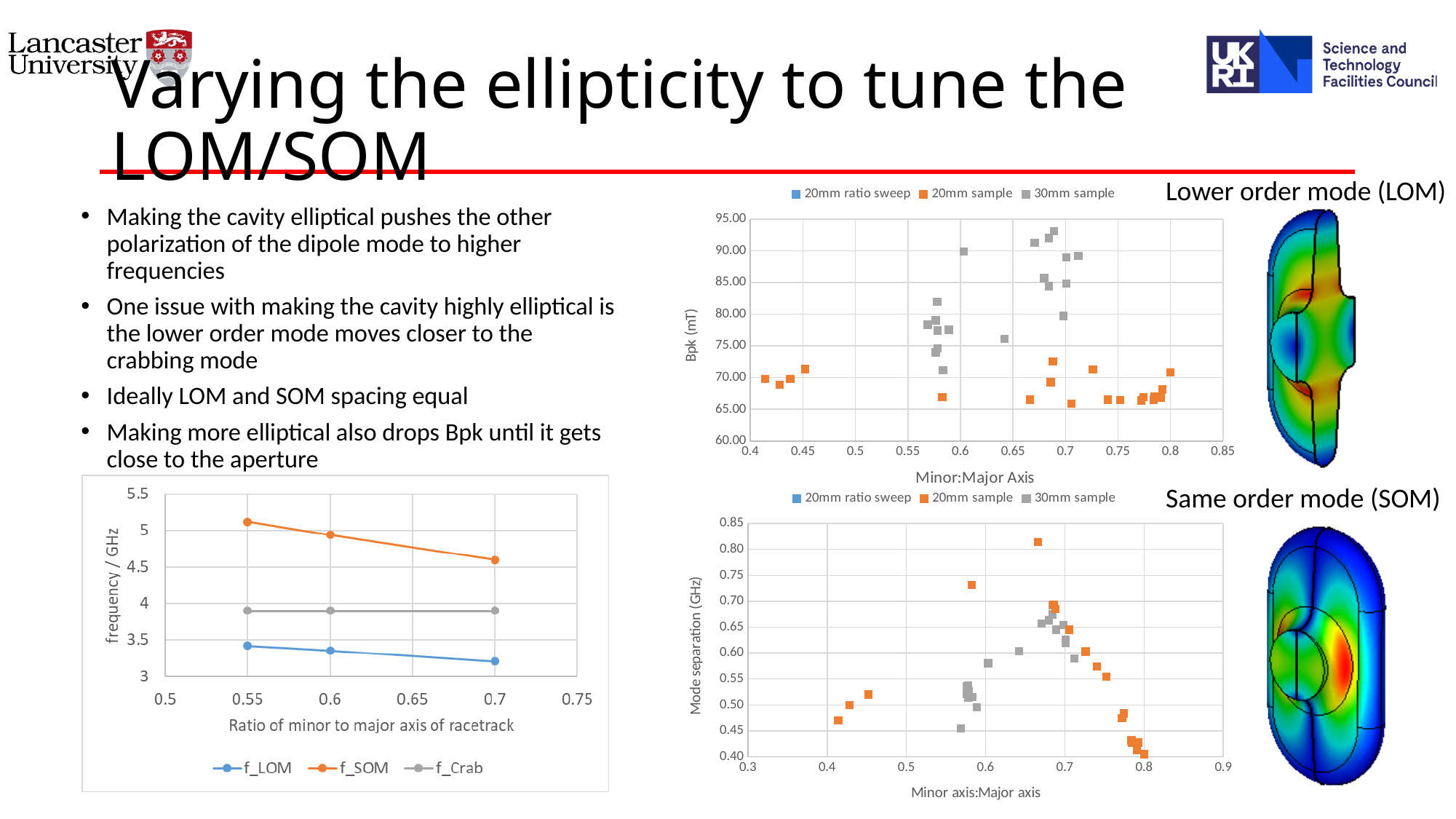
In the bottom-left line chart, is the f_LOM value at a ratio of 0.55 greater or less than 3.5? less In the bottom-left line chart, is the f_SOM value at a ratio of 0.55 greater or less than 5? greater In the bottom-left line chart, which series has the lowest frequency values? f_LOM How many series does the legend of the bottom-left line chart list? 3 In the bottom-left line chart, which series has the highest frequency values? f_SOM What kind of chart is the top-right chart with the y axis 'Bpk (mT)'? scatter chart What kind of chart is the bottom-left chart with the x axis 'Ratio of minor to major axis of racetrack'? line chart In the bottom-left line chart, how many data points are plotted for the f_LOM series? 3 What is the x-axis title of the bottom-right 'Mode separation (GHz)' chart? Minor axis:Major axis In the top-right Bpk chart, which series has the higher Bpk values, 20mm sample or 30mm sample? 30mm sample In the bottom-left line chart, does f_SOM rise or fall as the ratio of minor to major axis increases? fall In the bottom-left line chart, is the f_Crab value at a ratio of 0.7 greater or less than 4? less